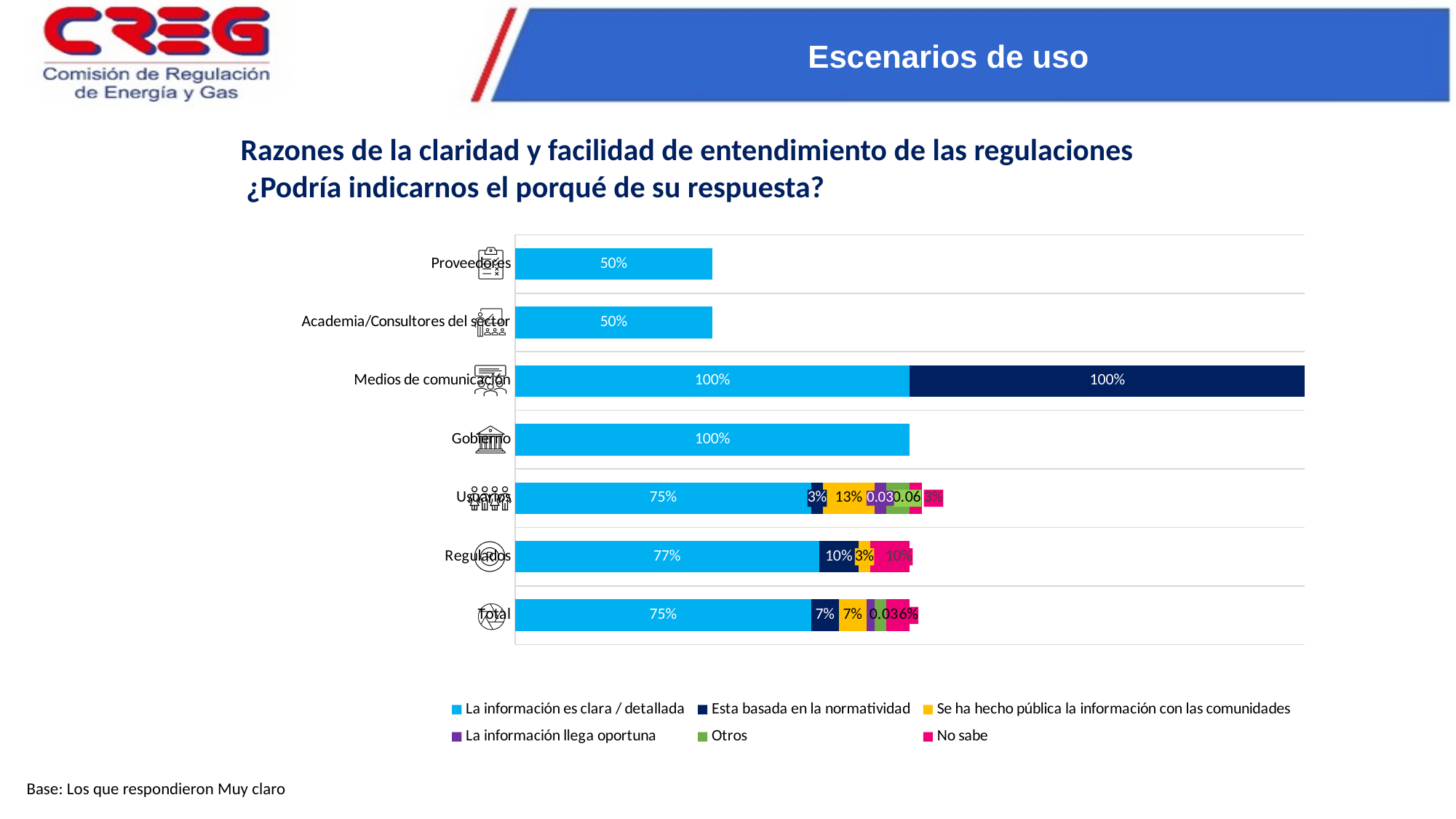
Which has a larger value for "La información es clara / detallada", Regulados or Usuarios? Regulados What is the value of "La información es clara / detallada" for Regulados? 77% What is the value of "Esta basada en la normatividad" for Regulados? 10% What is the value of "Se ha hecho pública la información con las comunidades" for Usuarios? 13% What is the value of "La información es clara / detallada" for Proveedores? 50% What is the difference between the "Se ha hecho pública la información con las comunidades" values for Usuarios and Total? 6 percentage points How many categories are plotted on the vertical axis? 7 What colour represents "No sabe" in the legend? Pink How many series does the legend list? 6 What kind of chart is shown on the slide? Stacked bar chart What is the value of "Esta basada en la normatividad" for Medios de comunicación? 100% What is the value of "No sabe" for Total? 6%